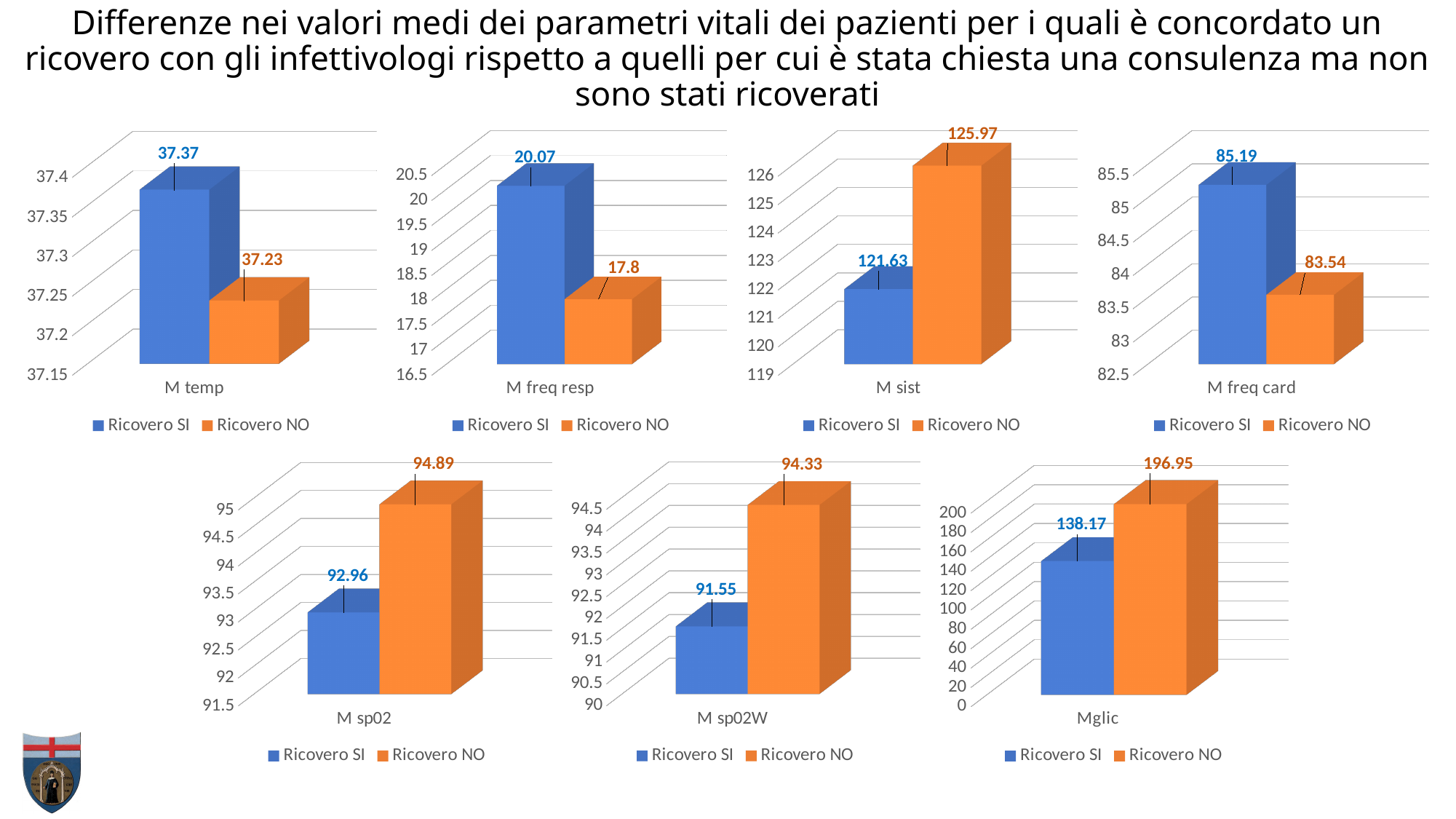
What kind of chart is the one labelled M freq card? Bar chart In the chart labelled M sp02W, which series has the higher value, Ricovero SI or Ricovero NO? Ricovero NO In the chart labelled Mglic, what is the value for Ricovero SI? 138.17 In the chart labelled M sp02, what is the difference between the Ricovero NO value and the Ricovero SI value? 1.93 In the chart labelled M freq resp, which series has the higher value, Ricovero SI or Ricovero NO? Ricovero SI In the chart labelled Mglic, what is the difference between the Ricovero NO value and the Ricovero SI value? 58.78 How many series does the legend of the chart labelled M sist list? 2 In the chart labelled M sist, what is the value for Ricovero NO? 125.97 How many charts are shown on the slide? 7 In the chart labelled M freq resp, what is the value for Ricovero NO? 17.8 In the chart labelled M temp, what is the value for Ricovero SI? 37.37 In the chart labelled M freq card, what is the value for Ricovero SI? 85.19